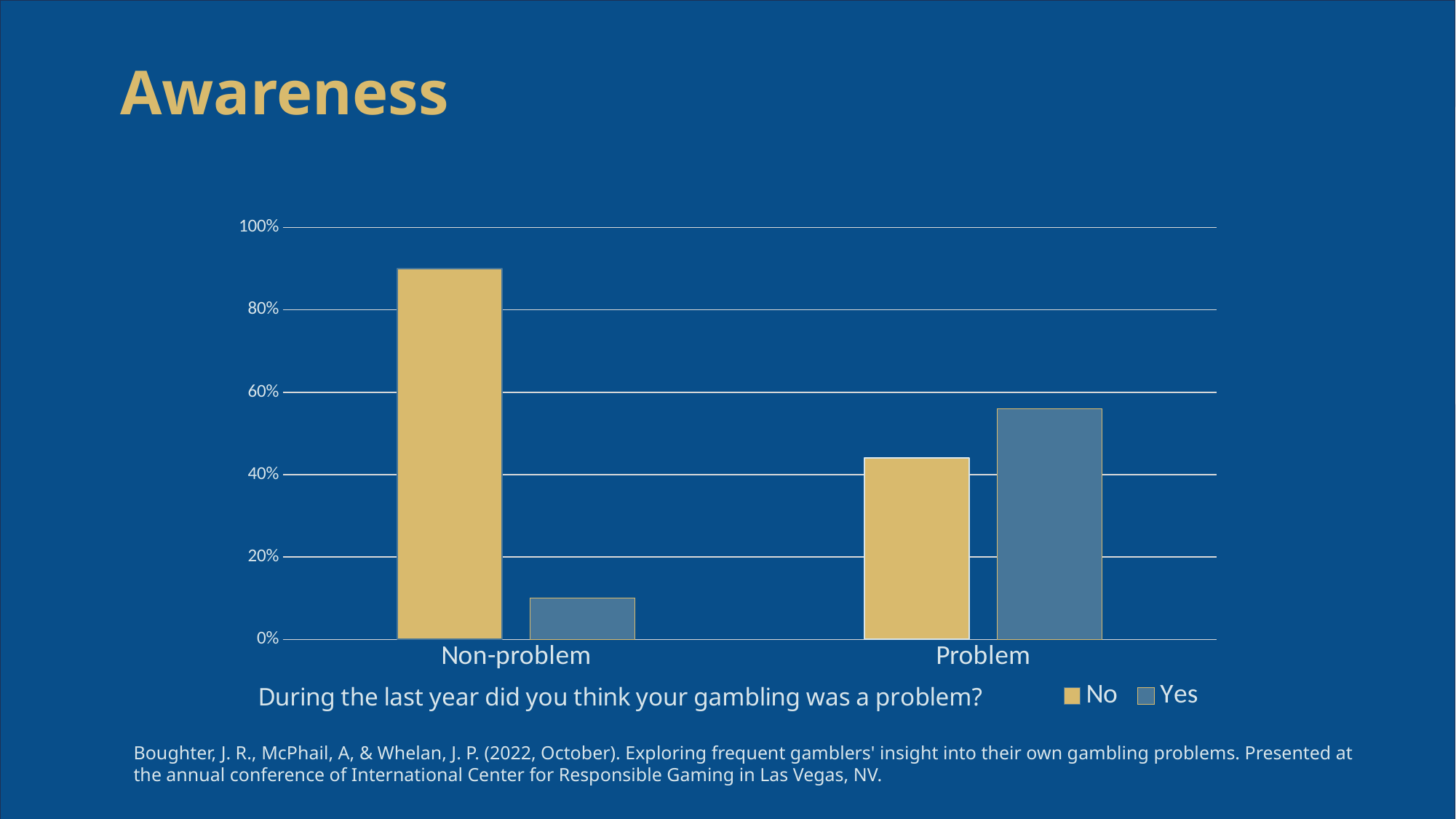
How many categories are shown on the x axis? 2 Is the value for Yes in the Problem group greater or less than 60%? less Is the value for No in the Non-problem group greater or less than 80%? greater Which bar is the shortest in the chart? Yes for Non-problem How many series does the legend list? 2 In the Non-problem group, which is larger, the No bar or the Yes bar? No In the Problem group, which is larger, the No bar or the Yes bar? Yes Is the value for Yes in the Non-problem group greater or less than 20%? less What question is written beneath the x axis of the chart? During the last year did you think your gambling was a problem? What kind of chart is shown on the slide? bar chart Which bar is the tallest in the chart? No for Non-problem